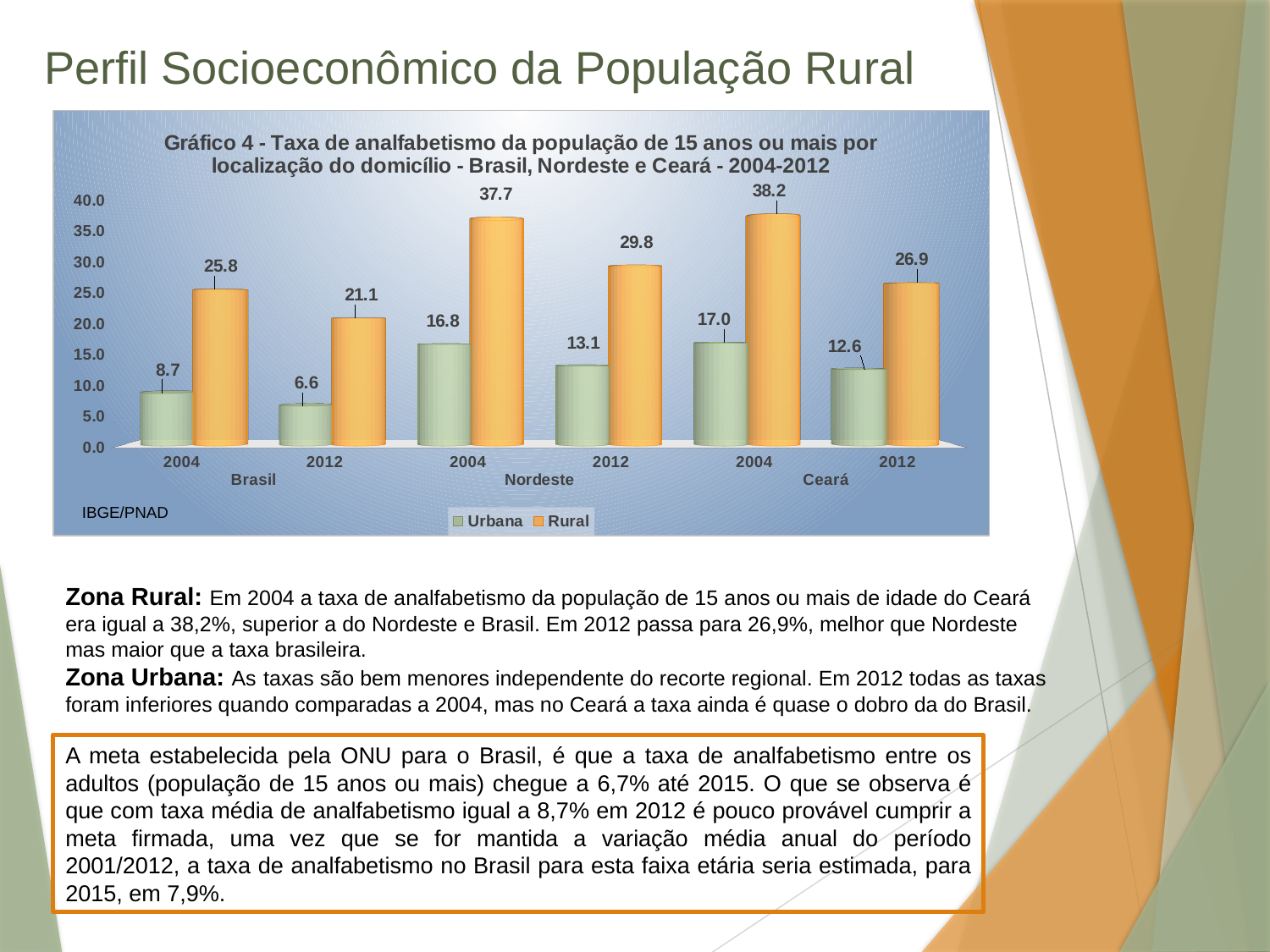
Which category has the highest Rural value? Ceará 2004 How many series does the legend list? 2 Which is larger, the Urbana value for Ceará in 2012 or the Urbana value for Nordeste in 2012? Nordeste 2012 Which category has the lowest Urbana value? Brasil 2012 By how much did the Rural value for Ceará fall from 2004 to 2012? 11.3 How many year-region categories are shown on the x axis? 6 What kind of chart is shown on the slide? Bar chart What is the Rural illiteracy rate for Ceará in 2004? 38.2 What is the Urbana value for Brasil in 2012? 6.6 What is the difference between the Rural and Urbana values for Nordeste in 2004? 20.9 What is the Rural value for Nordeste in 2012? 29.8 What is the data source noted on the chart? IBGE/PNAD